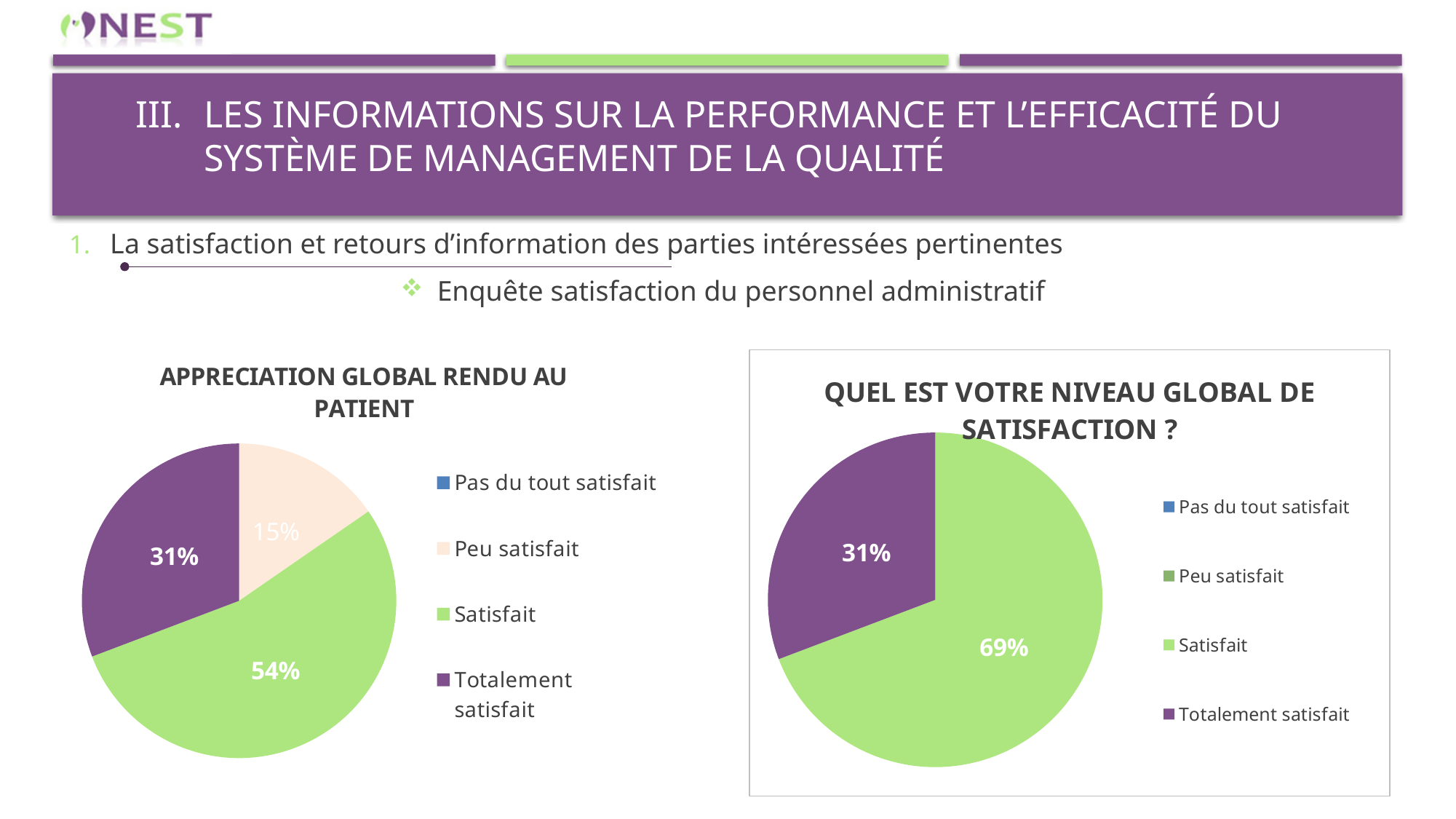
How many entries does the legend of the chart titled "APPRECIATION GLOBAL RENDU AU PATIENT" list? 4 In the chart titled "QUEL EST VOTRE NIVEAU GLOBAL DE SATISFACTION ?", what is the value for "Totalement satisfait"? 31% In the chart titled "QUEL EST VOTRE NIVEAU GLOBAL DE SATISFACTION ?", which is larger, "Satisfait" or "Totalement satisfait"? Satisfait In the chart titled "APPRECIATION GLOBAL RENDU AU PATIENT", what is the value for "Totalement satisfait"? 31% What kind of chart is the chart titled "QUEL EST VOTRE NIVEAU GLOBAL DE SATISFACTION ?"? Pie chart In the chart titled "QUEL EST VOTRE NIVEAU GLOBAL DE SATISFACTION ?", what is the value for "Satisfait"? 69% In the chart titled "APPRECIATION GLOBAL RENDU AU PATIENT", which labelled slice is the smallest? Peu satisfait In the chart titled "APPRECIATION GLOBAL RENDU AU PATIENT", what is the difference between the "Satisfait" and "Totalement satisfait" shares? 23% In the chart titled "QUEL EST VOTRE NIVEAU GLOBAL DE SATISFACTION ?", what is the difference between the "Satisfait" and "Totalement satisfait" shares? 38% In the chart titled "APPRECIATION GLOBAL RENDU AU PATIENT", what share of the pie is "Satisfait"? 54% In the chart titled "APPRECIATION GLOBAL RENDU AU PATIENT", what is the value for "Peu satisfait"? 15% In the chart titled "APPRECIATION GLOBAL RENDU AU PATIENT", which category has the largest slice? Satisfait